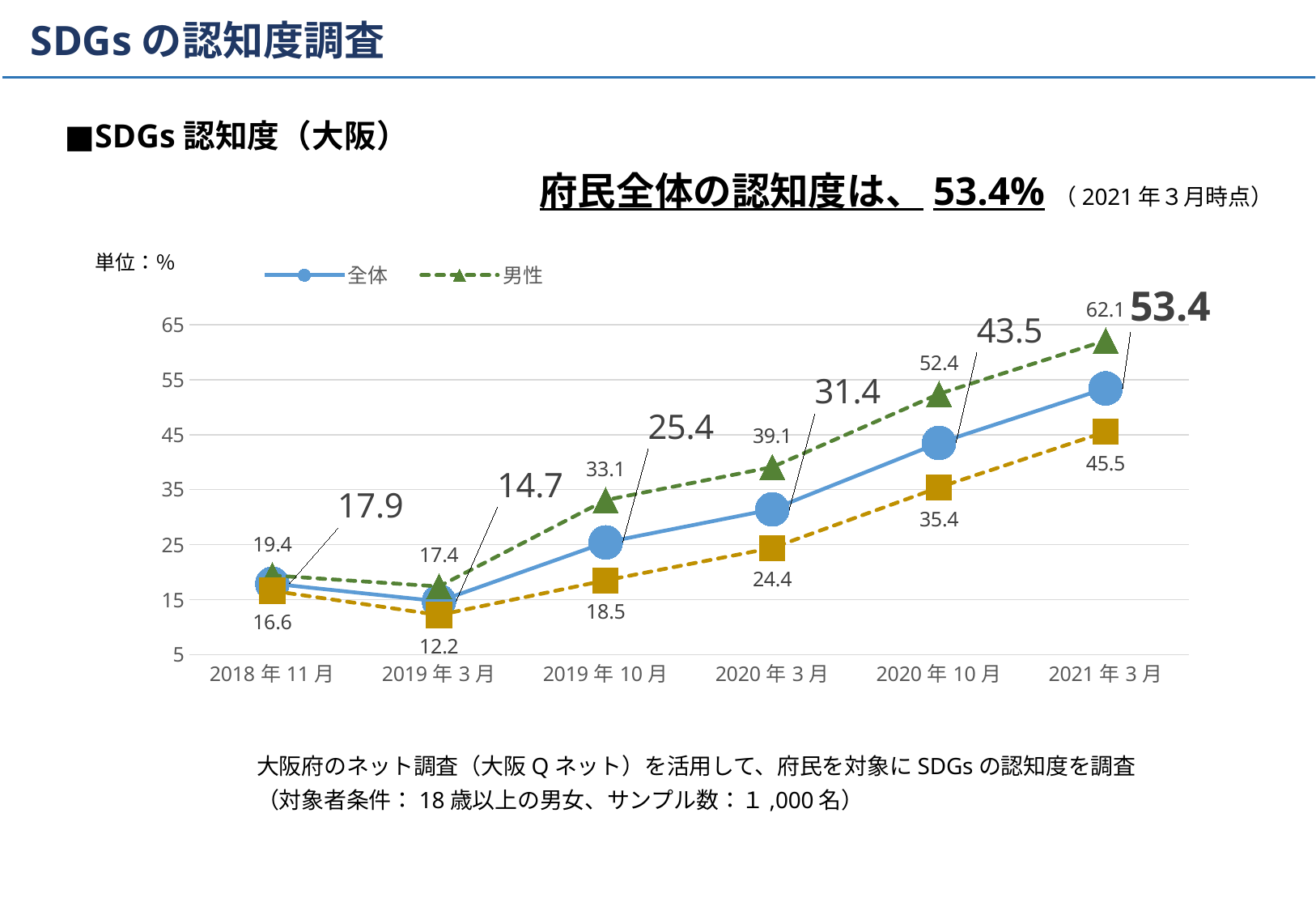
What is the value for 男性 at 2019年10月? 33.1 How many time points are plotted on the x axis? 6 What type of chart is shown on the slide? line chart From 2019年3月 to 2021年3月, does the 全体 series rise or fall? rise What is the value for 全体 at 2021年3月? 53.4 What is the value for 全体 at 2019年3月? 14.7 How many series does the legend list? 2 What is the value for 男性 at 2018年11月? 19.4 At which time point is the 全体 series lowest? 2019年3月 What is the difference between 男性 and 全体 at 2021年3月? 8.7 Which is larger at 2020年10月, 全体 or 男性? 男性 At which time point is the 男性 series highest? 2021年3月